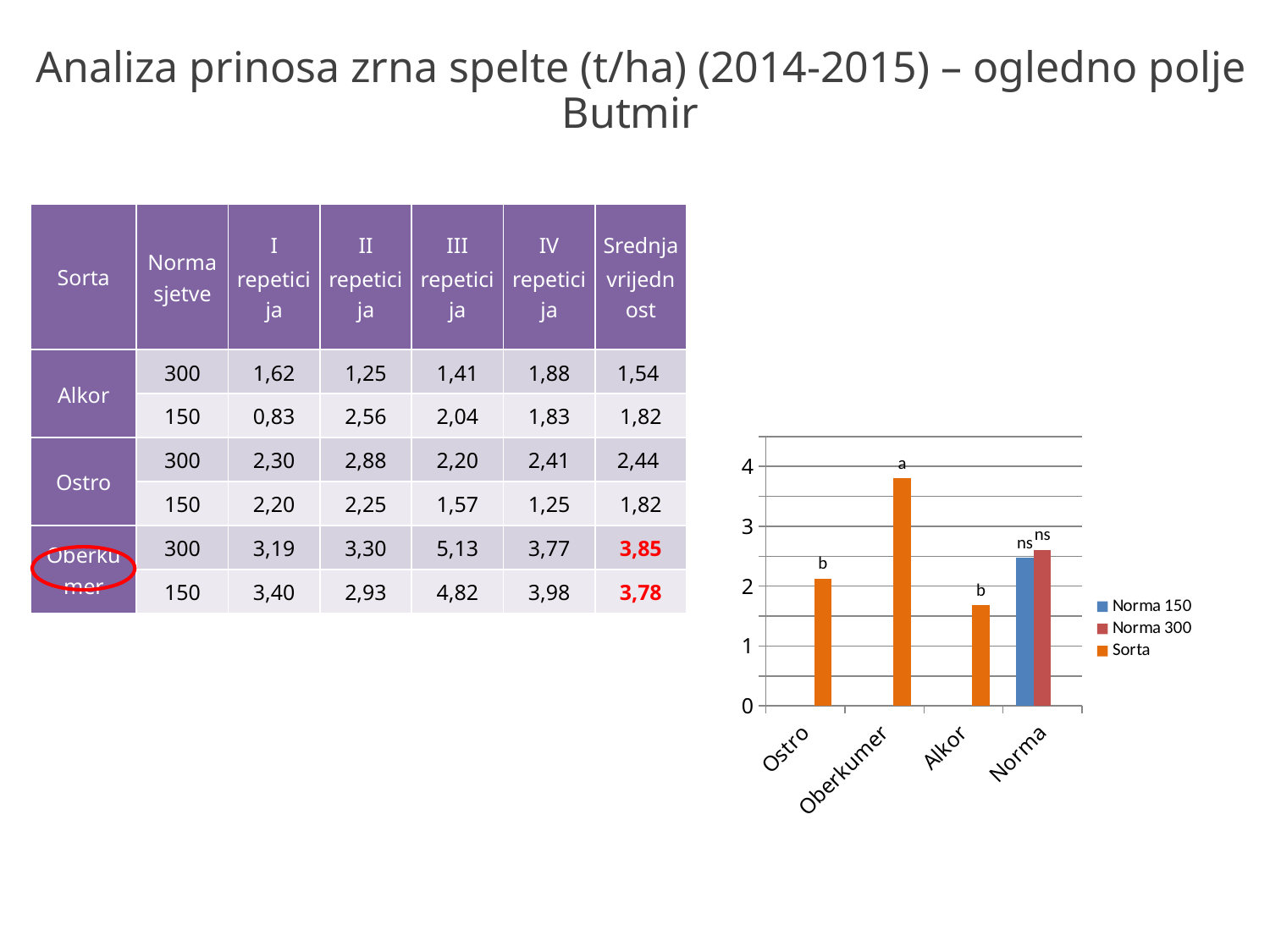
Is the Norma 150 bar in the Norma category greater or less than 2? greater Which category has the shortest bar in the chart? Alkor Is the bar for Oberkumer greater or less than 3? greater What colour are the Sorta bars in the chart? orange How many series does the chart's legend list? 3 Which category has the tallest bar in the chart? Oberkumer Which is larger, the bar for Oberkumer or the bar for Alkor? Oberkumer What are the three entries listed in the chart's legend? Norma 150, Norma 300, Sorta What kind of chart is shown on the slide? bar chart Is the bar for Alkor greater or less than 2? less How many categories are shown on the x axis of the chart? 4